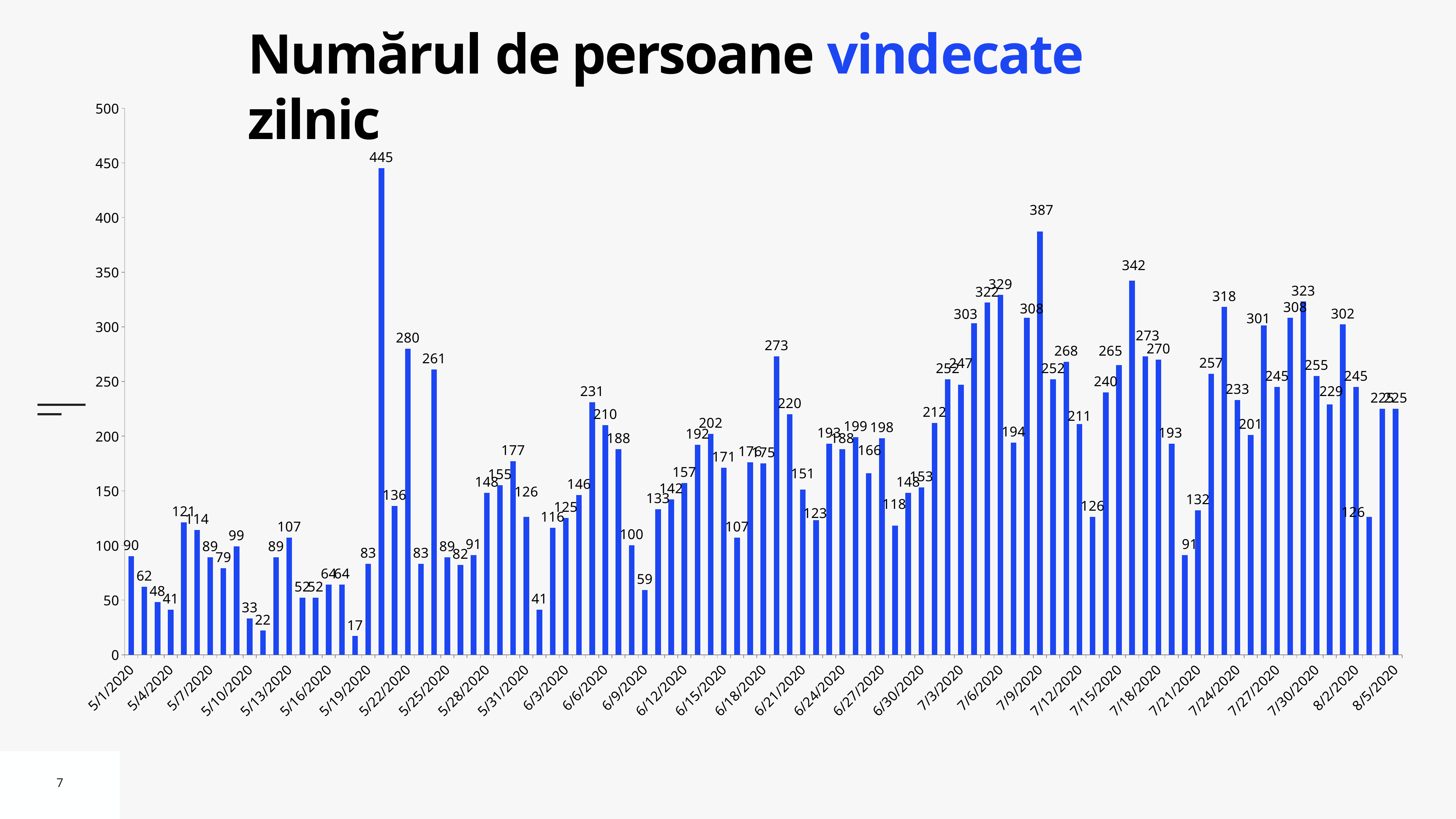
What is the value for 7/9/2020? 387 What is the value for 5/22/2020? 280 Which is larger, the value for 5/22/2020 or the value for 6/6/2020? 5/22/2020 What is the lowest value shown on the chart? 17 What is the highest value shown on the chart? 445 What is the value for 6/9/2020? 59 What is the difference between the values for 7/9/2020 and 7/3/2020? 140 What is the title of the chart? Numărul de persoane vindecate zilnic What kind of chart is shown on the slide? bar chart Is the value for 7/6/2020 greater or less than 300? greater What is the value for 5/1/2020? 90 What is the value for 8/5/2020? 225